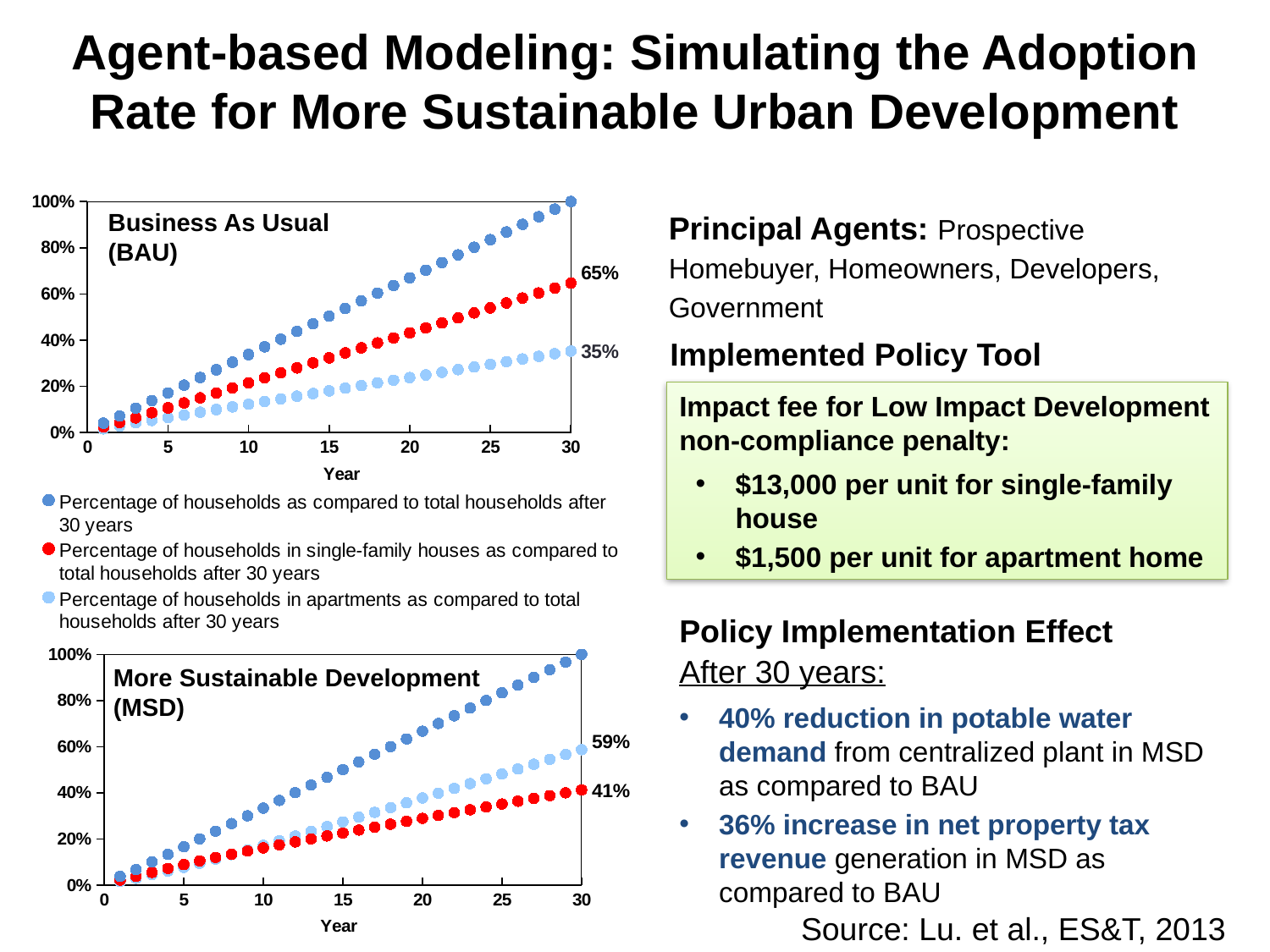
What is the x-axis title of the Business As Usual (BAU) chart? Year In the Business As Usual (BAU) chart, what is the value labelled for the apartments series at year 30? 35% In the More Sustainable Development (MSD) chart, what is the value labelled for the apartments series at year 30? 59% In the Business As Usual (BAU) chart, what is the value labelled for the single-family houses series at year 30? 65% In the More Sustainable Development (MSD) chart, what is the difference between the apartments value and the single-family houses value at year 30? 18% Do the values in the More Sustainable Development (MSD) chart rise or fall as the year increases? rise How many series does the legend list? 3 In the Business As Usual (BAU) chart, what is the difference between the single-family houses value and the apartments value at year 30? 30% In the Business As Usual (BAU) chart, which of the three series is lowest at year 30? Percentage of households in apartments as compared to total households after 30 years In the More Sustainable Development (MSD) chart, which is larger at year 30: the apartments series or the single-family houses series? Apartments In the Business As Usual (BAU) chart, is the value for the single-family houses series at year 20 greater or less than 60%? less In the More Sustainable Development (MSD) chart, what is the value labelled for the single-family houses series at year 30? 41%